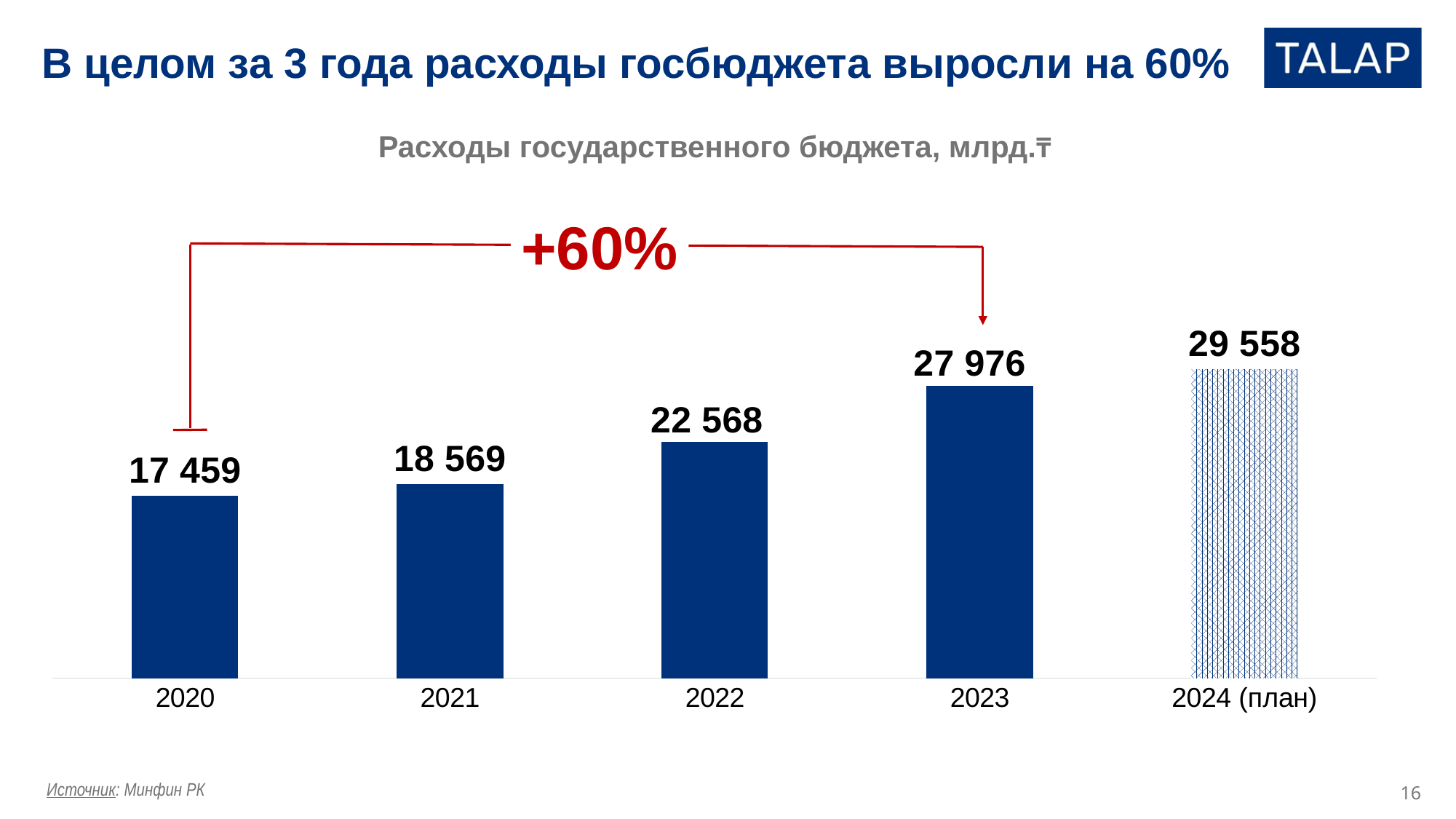
What is the difference between the values for 2022 and 2021? 3 999 What is the difference between the values for 2023 and 2020? 10 517 What is the title of the chart? Расходы государственного бюджета, млрд.₸ Which year has the lowest value? 2020 What is the value for 2022? 22 568 Which year has the highest value? 2024 (план) What kind of chart is this? bar chart Do the values rise or fall from 2020 to 2024 (план)? rise What is the value for 2024 (план)? 29 558 How many categories are shown on the x axis? 5 Which is larger, the value for 2021 or the value for 2023? 2023 What is the value for 2020? 17 459